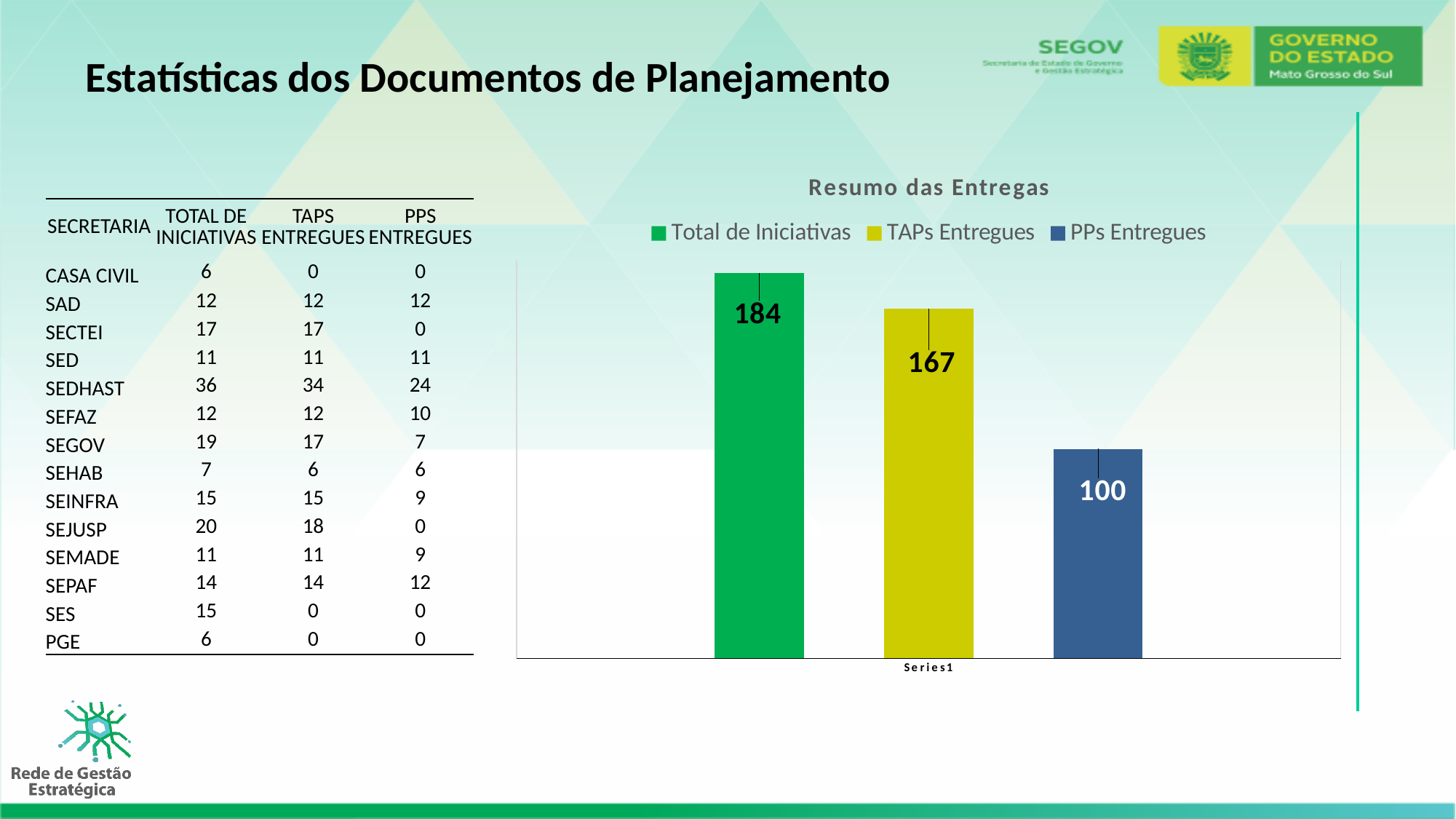
What is the value of PPs Entregues in the Resumo das Entregas chart? 100 What is the value of TAPs Entregues in the Resumo das Entregas chart? 167 What is the value of Total de Iniciativas in the Resumo das Entregas chart? 184 What kind of chart is the Resumo das Entregas chart? Bar chart Which series has the highest value in the Resumo das Entregas chart? Total de Iniciativas What is the difference between Total de Iniciativas and TAPs Entregues in the Resumo das Entregas chart? 17 In the Resumo das Entregas chart, which is larger: TAPs Entregues or PPs Entregues? TAPs Entregues How many series does the legend of the Resumo das Entregas chart list? 3 What is the difference between TAPs Entregues and PPs Entregues in the Resumo das Entregas chart? 67 What is the difference between Total de Iniciativas and PPs Entregues in the Resumo das Entregas chart? 84 What colour is the bar for PPs Entregues in the Resumo das Entregas chart? Blue Which series has the lowest value in the Resumo das Entregas chart? PPs Entregues